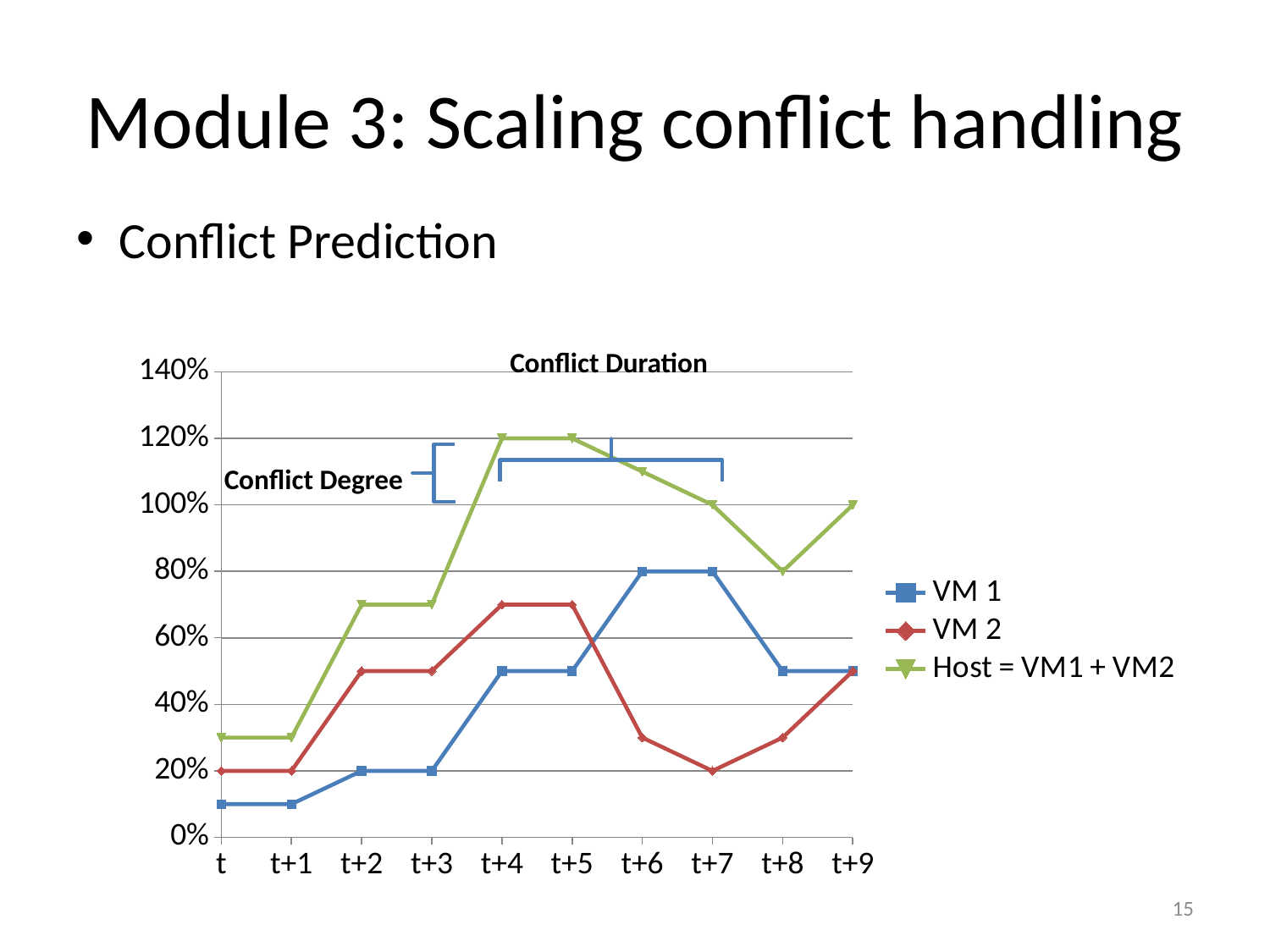
How many series does the legend list? 3 What is the value of the Host = VM1 + VM2 series at t+4? 120% What is the value of VM 2 at t+7? 20% At t+6, which is larger, VM 1 or VM 2? VM 1 Does the Host = VM1 + VM2 series rise or fall from t to t+4? rise What is the difference between the Host = VM1 + VM2 value at t+4 and at t+8? 40% What kind of chart is shown on the slide? line chart How many time points are shown on the x axis? 10 Is the value for VM 1 at t greater or less than 20%? less What is the value of VM 1 at t+6? 80% What is the value of the Host = VM1 + VM2 series at t+8? 80% Is the value for VM 2 at t+4 greater or less than 60%? greater